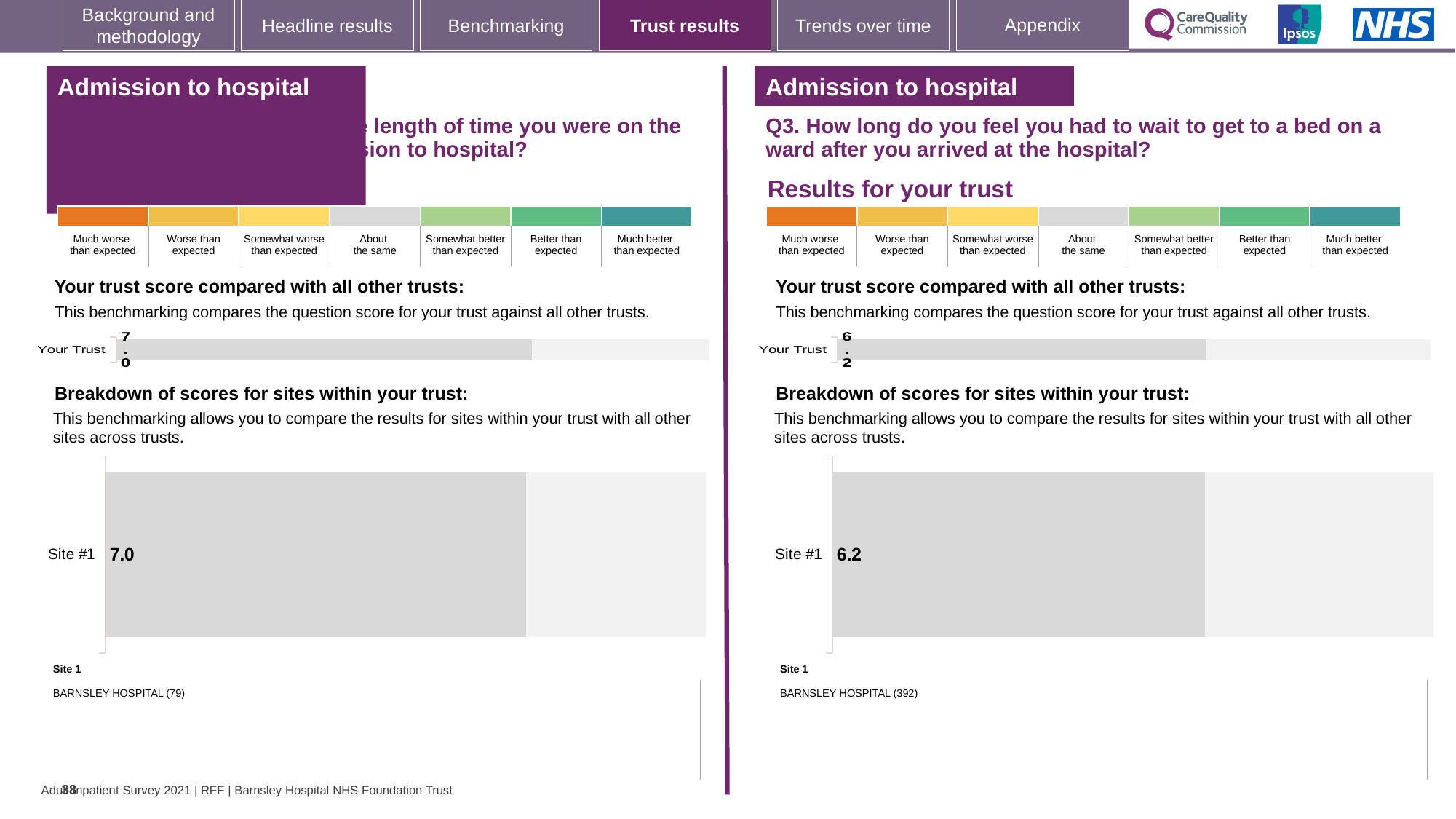
What type of chart is used to show the Site #1 score on the left half of the slide? Bar chart Is the Your Trust score on the right half of the slide (Q3) greater or less than 7? less On the left half of the slide, what score is shown for Site #1 in the 'Breakdown of scores for sites within your trust' chart? 7.0 Which is larger: the Your Trust score on the left half of the slide or the Your Trust score on the right half (Q3)? Left half (7.0) On the left half of the slide, what number appears in brackets after BARNSLEY HOSPITAL in the Site 1 label? 79 On the right half of the slide (Q3), what score is shown for Site #1 in the 'Breakdown of scores for sites within your trust' chart? 6.2 On the right half of the slide (Q3), which site name is listed as Site 1 below the breakdown chart? BARNSLEY HOSPITAL (392) What is the difference between the Site #1 score on the left half of the slide and the Site #1 score on the right half (Q3)? 0.8 On the left half of the slide, what is the score shown for Your Trust in the 'Your trust score compared with all other trusts' chart? 7.0 On the right half of the slide (Q3), what is the score shown for Your Trust in the 'Your trust score compared with all other trusts' chart? 6.2 How many sites are shown in the 'Breakdown of scores for sites within your trust' chart on the right half of the slide (Q3)? 1